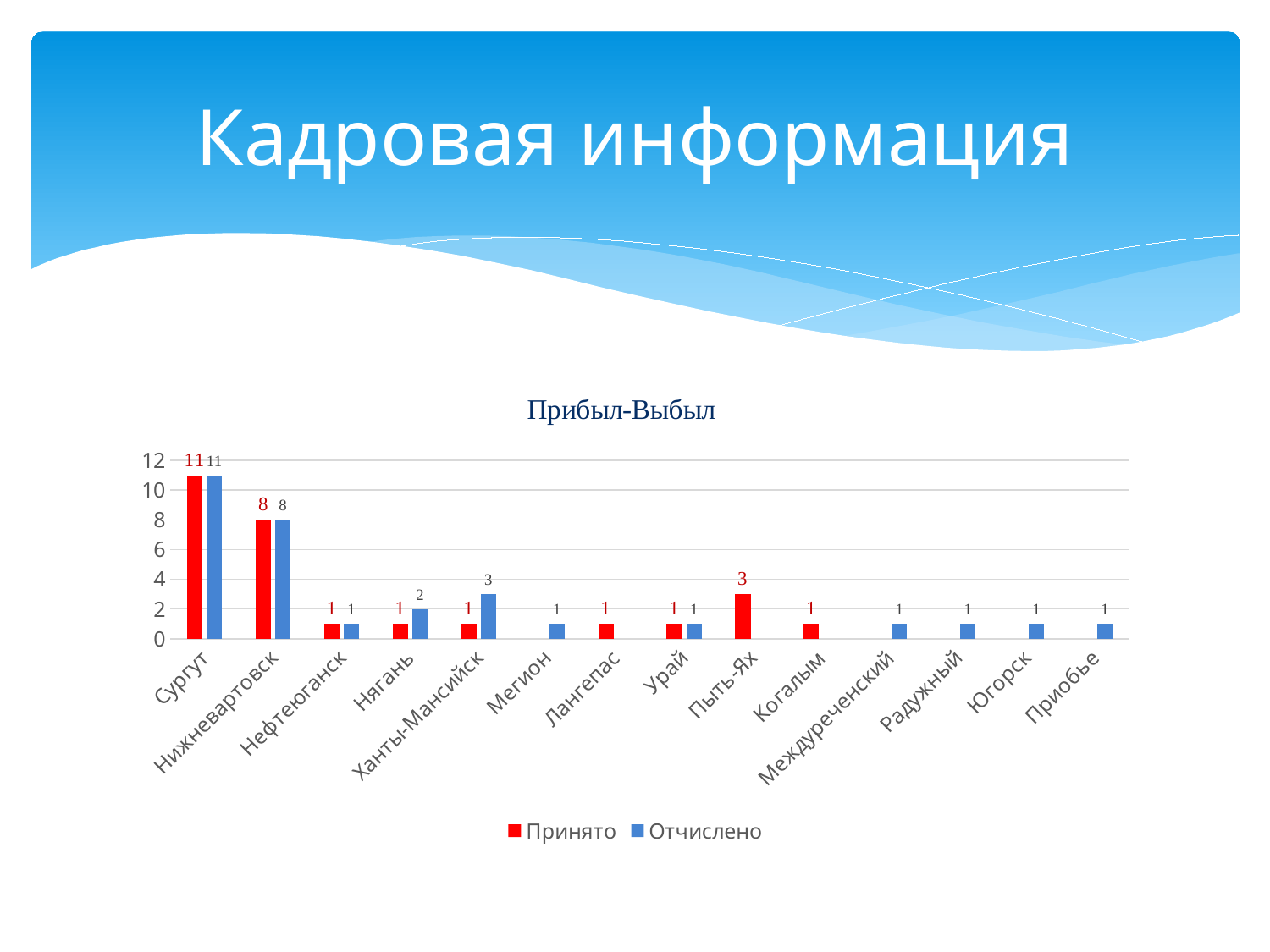
What kind of chart is shown on the slide? bar chart What is the difference between the Принято values for Сургут and Нижневартовск? 3 Which category has the highest value of Принято? Сургут What is the title of the chart? Прибыл-Выбыл What is the value of Принято for Сургут? 11 How many series does the legend list? 2 Which colour represents the Отчислено series? blue What is the difference between Отчислено and Принято for Нягань? 1 What is the value of Принято for Пыть-Ях? 3 Which is larger for Ханты-Мансийск, Принято or Отчислено? Отчислено What is the value of Отчислено for Ханты-Мансийск? 3 How many categories are shown on the x axis? 14